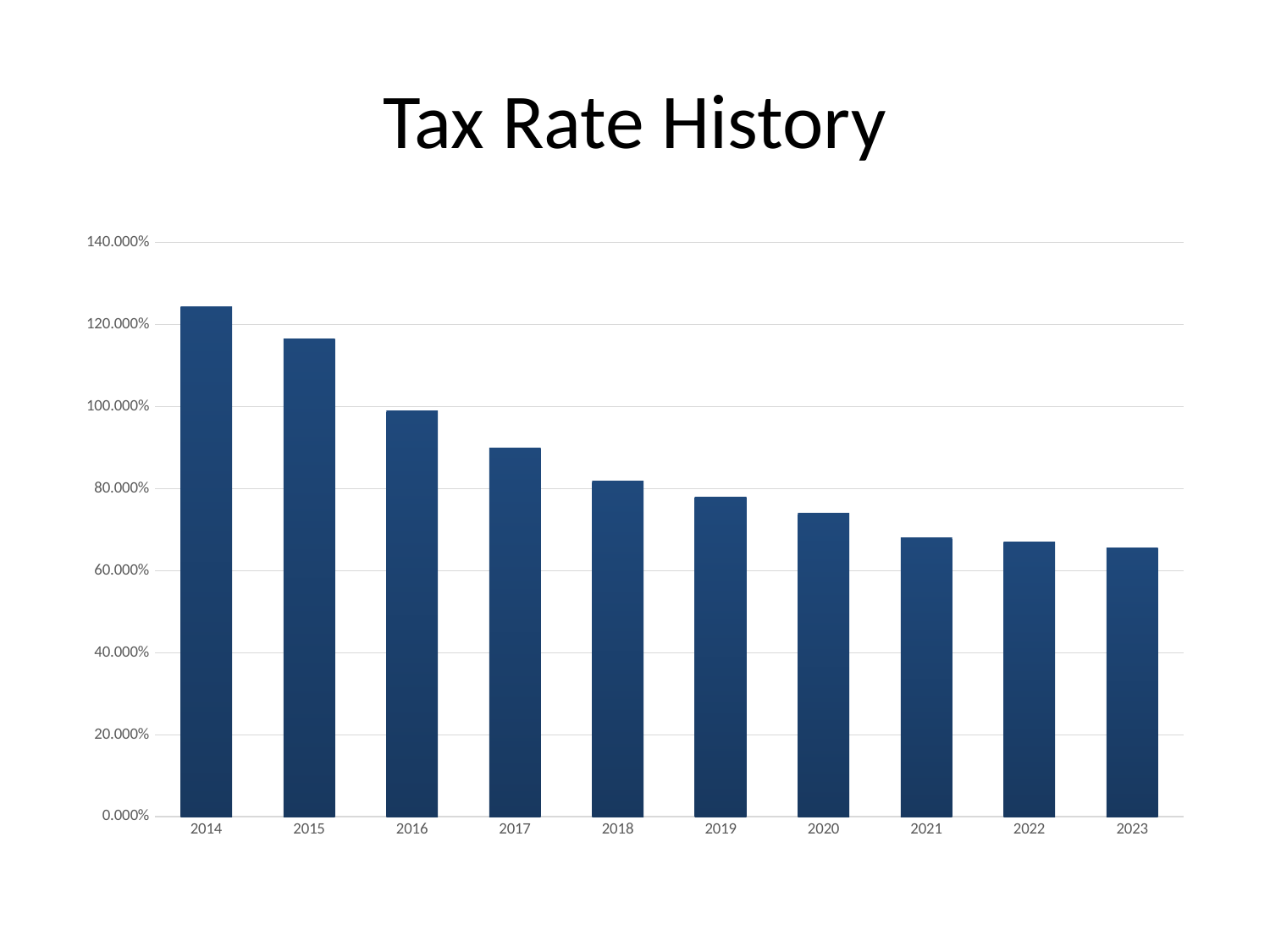
Is the value for 2014 greater or less than 120.000%? greater Is the value for 2023 greater or less than 80.000%? less What is the title of the chart? Tax Rate History Do the tax rates rise or fall from 2014 to 2023? fall Which is larger, the value for 2014 or the value for 2015? 2014 Is the value for 2017 greater or less than 80.000%? greater How many years are shown on the x axis of the chart? 10 Which year has the highest tax rate? 2014 Which year has the lowest tax rate? 2023 What kind of chart is shown on the slide? bar chart Which is larger, the value for 2020 or the value for 2021? 2020